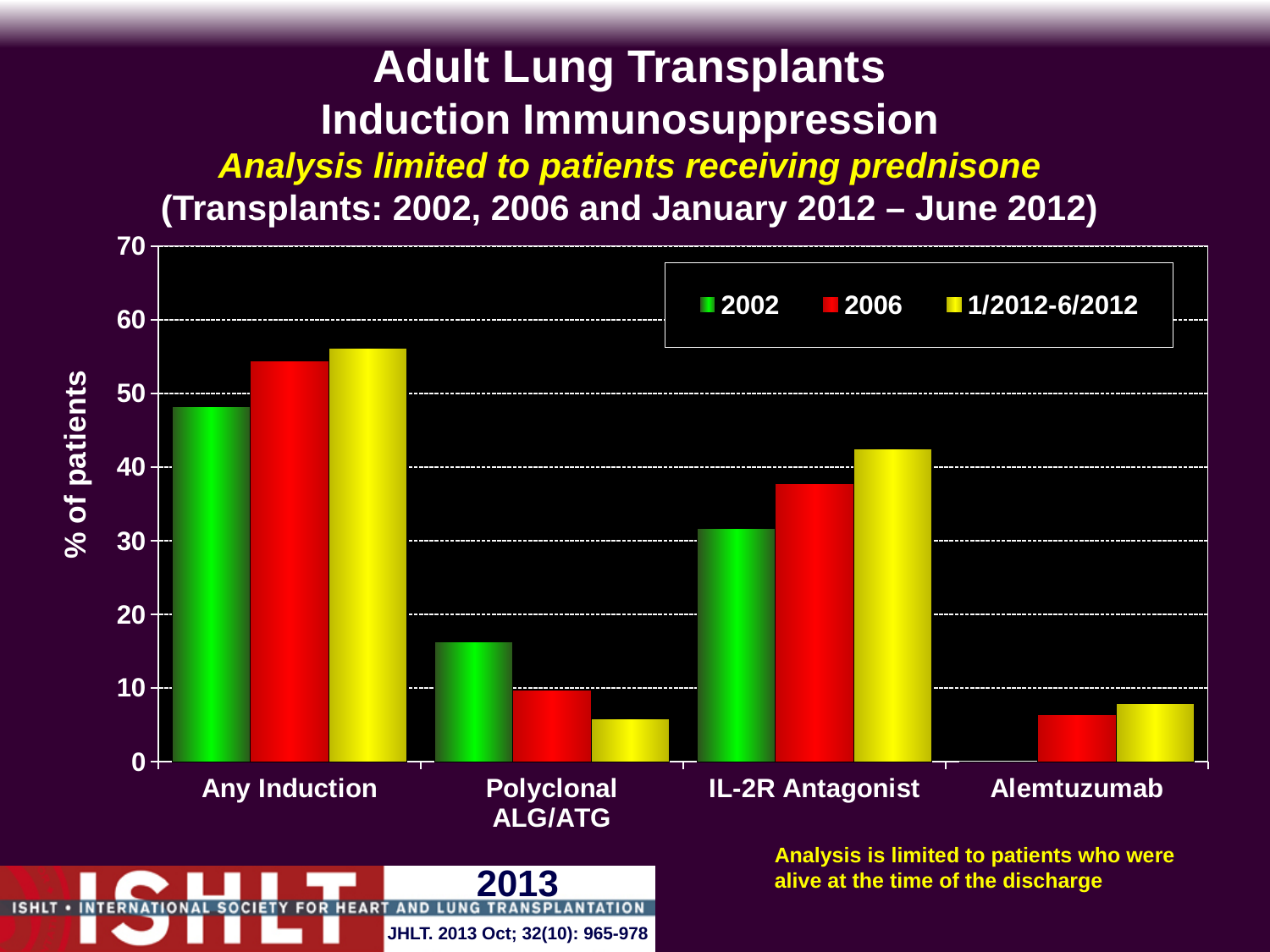
Is the 2002 value for Polyclonal ALG/ATG greater or less than 10? greater Which series has the highest value for Any Induction? 1/2012-6/2012 How many induction categories are shown on the x axis? 4 For IL-2R Antagonist, which is larger: the 2002 value or the 2006 value? 2006 Which series has the lowest value for Polyclonal ALG/ATG? 1/2012-6/2012 What kind of chart is shown on the slide? bar chart Is the 2002 value for Any Induction greater or less than 40? greater How many series does the legend list? 3 Is the 1/2012-6/2012 value for Alemtuzumab greater or less than 10? less What is the label of the y axis? % of patients Which series has the highest value for Polyclonal ALG/ATG? 2002 Do the values for IL-2R Antagonist rise or fall from 2002 to 1/2012-6/2012? rise